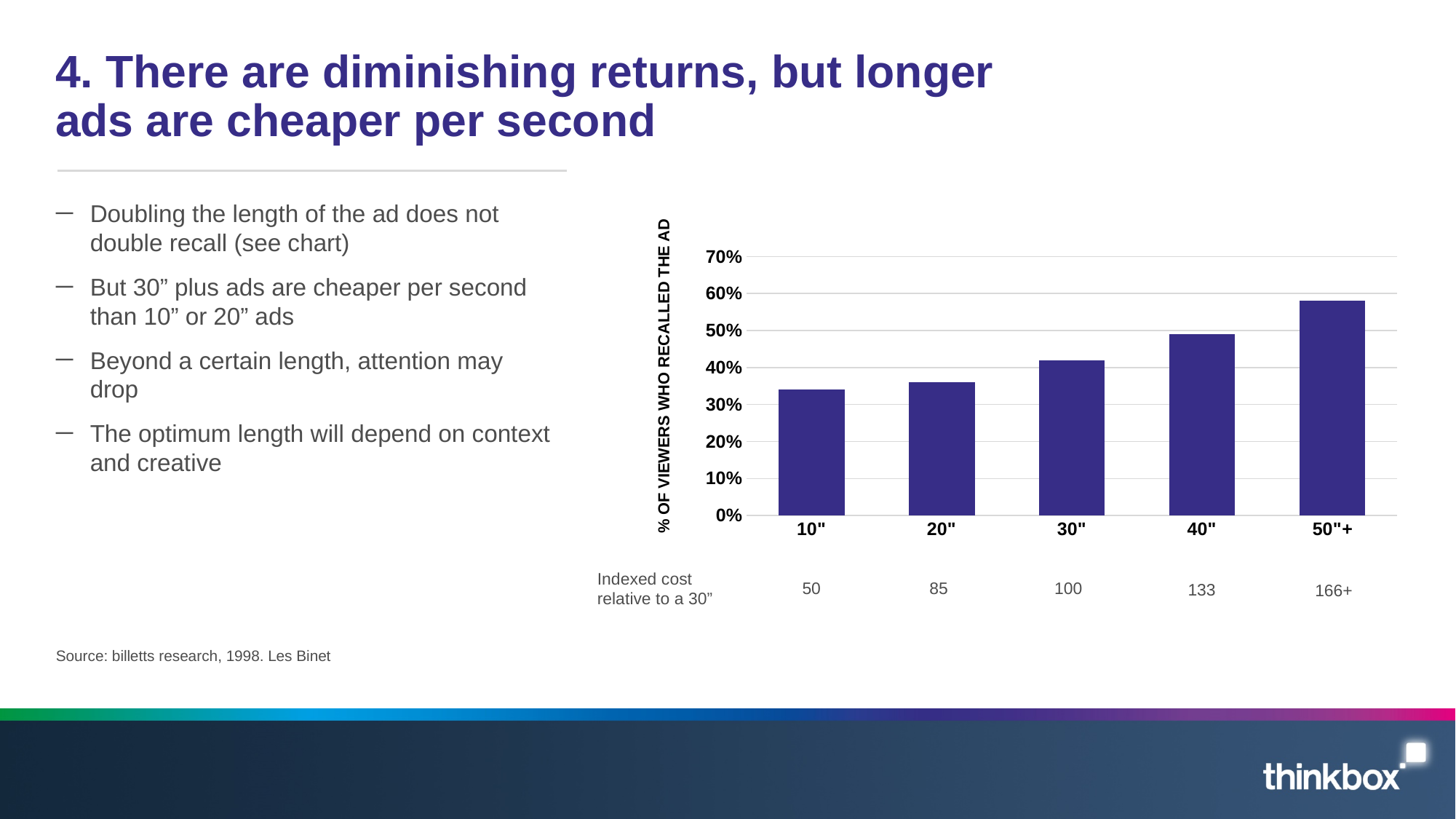
Is the value for 10" greater or less than 40%? less Is the value for 50"+ greater or less than 50%? greater What is the indexed cost relative to a 30" shown beneath the 40" bar? 133 What is the label on the vertical axis of the chart? % OF VIEWERS WHO RECALLED THE AD Which ad length has the highest percentage of viewers who recalled the ad? 50"+ Do the values rise or fall as ad length increases along the x axis? rise Is the value for 20" greater or less than 30%? greater What kind of chart is shown on the slide? bar chart How many ad-length categories are plotted on the chart? 5 Which has a higher recall percentage, 30" or 50"+? 50"+